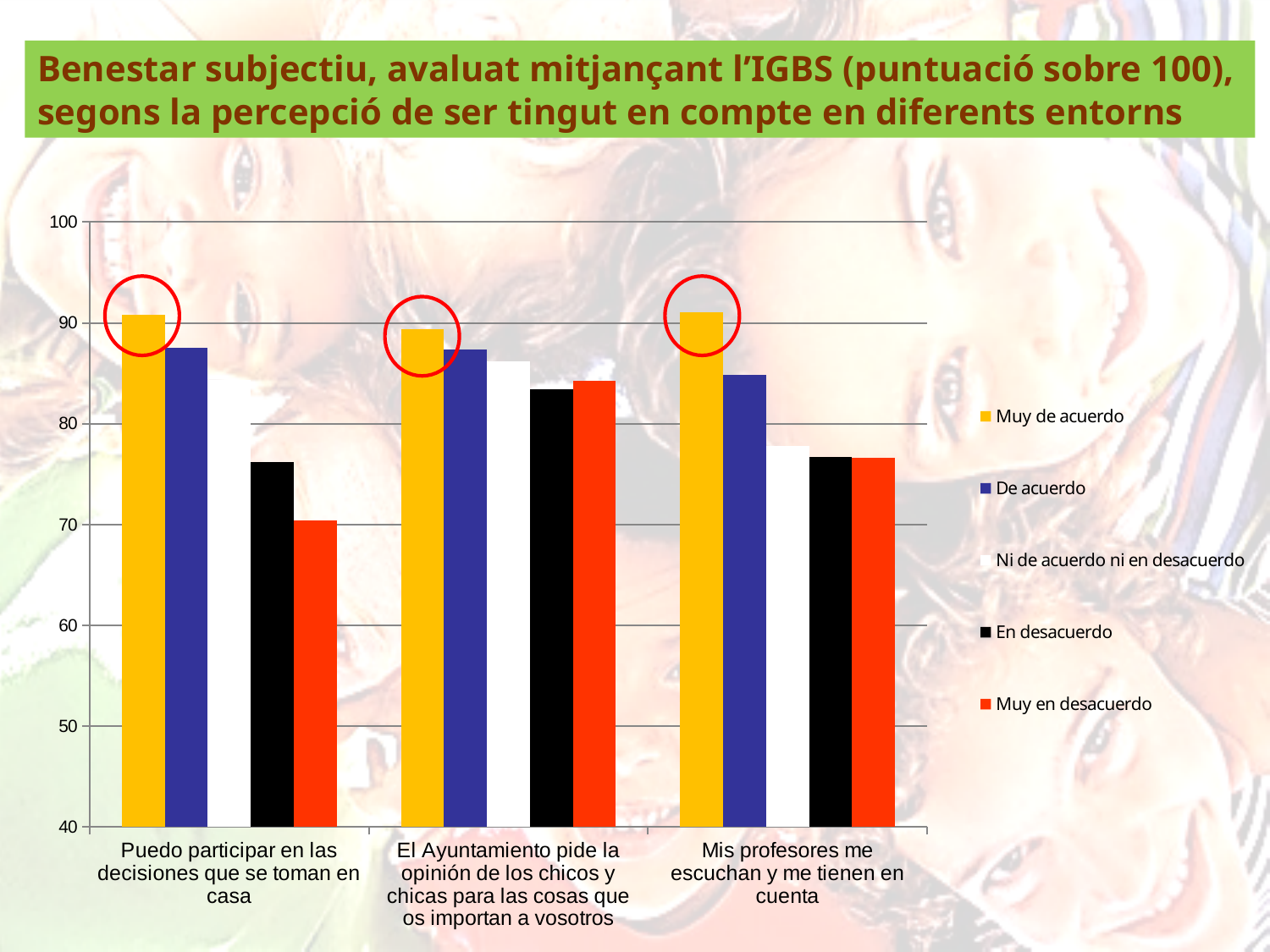
For the category 'Mis profesores me escuchan y me tienen en cuenta', which series has the highest bar? Muy de acuerdo What colour are the bars for the 'Muy de acuerdo' series? yellow How many series does the chart's legend list? 5 What kind of chart is shown on the slide? bar chart In the category 'Puedo participar en las decisiones que se toman en casa', which is larger: the value for 'Muy de acuerdo' or the value for 'Muy en desacuerdo'? Muy de acuerdo For the category 'Puedo participar en las decisiones que se toman en casa', which series has the highest bar? Muy de acuerdo Is the value for 'En desacuerdo' in the category 'Puedo participar en las decisiones que se toman en casa' greater or less than 80? less Is the value for 'Muy en desacuerdo' in the category 'Puedo participar en las decisiones que se toman en casa' greater or less than 80? less Is the value for 'Muy de acuerdo' in the category 'El Ayuntamiento pide la opinión de los chicos y chicas para las cosas que os importan a vosotros' greater or less than 80? greater How many categories are shown along the x axis of the chart? 3 Which is larger: the value for 'Muy en desacuerdo' in 'Puedo participar en las decisiones que se toman en casa' or in 'El Ayuntamiento pide la opinión de los chicos y chicas para las cosas que os importan a vosotros'? El Ayuntamiento pide la opinión de los chicos y chicas para las cosas que os importan a vosotros For the category 'Puedo participar en las decisiones que se toman en casa', which series has the lowest bar? Muy en desacuerdo